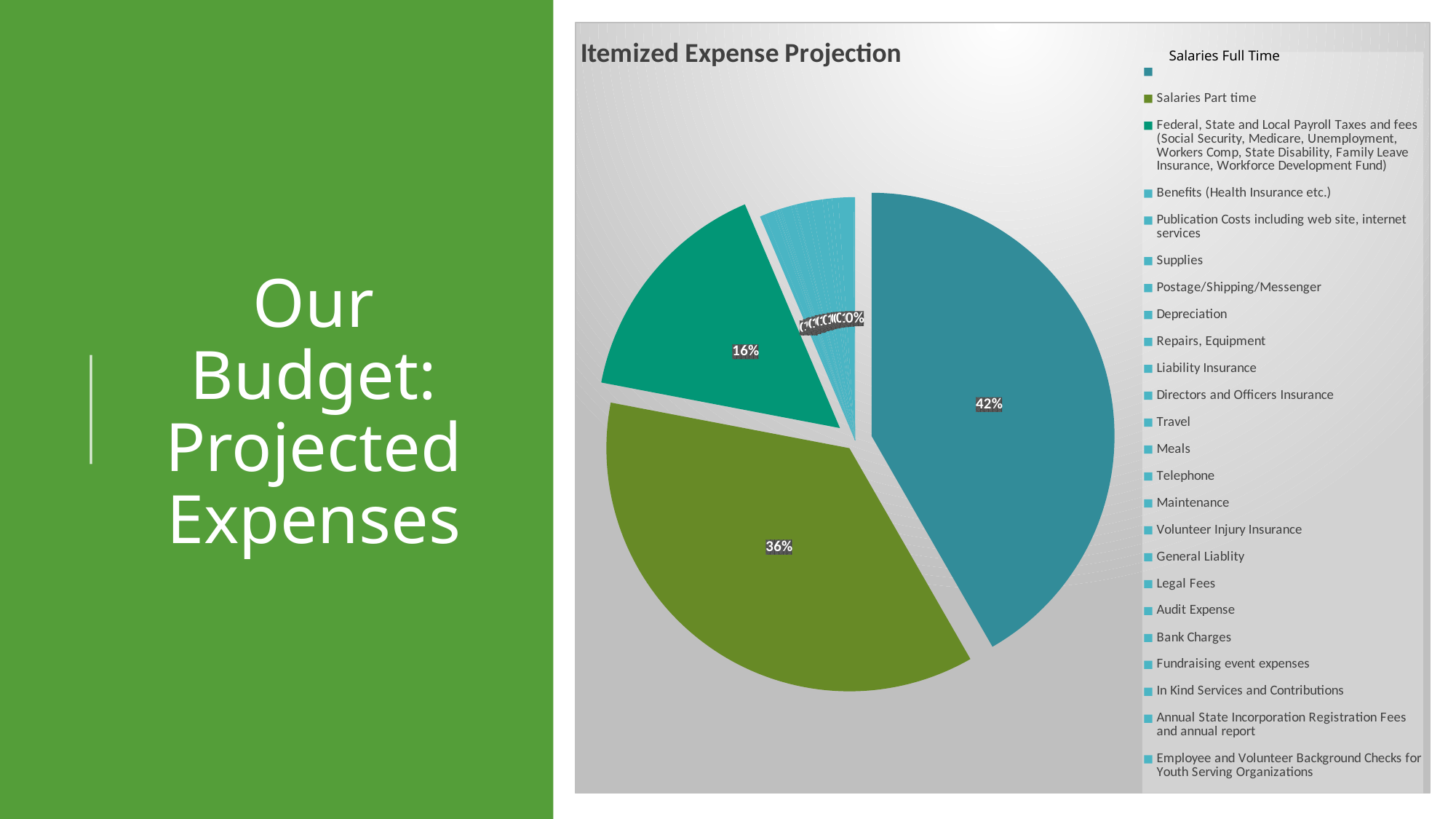
By how many percentage points does the Salaries Full Time slice exceed the Salaries Part time slice? 6 percentage points What share of the pie does Federal, State and Local Payroll Taxes and fees take? 16% Which category has the largest slice of the pie? Salaries Full Time What is the title of the chart? Itemized Expense Projection By how many percentage points does the Salaries Part time slice exceed the Federal, State and Local Payroll Taxes and fees slice? 20 percentage points What share of the pie does Salaries Full Time take? 42% What colour is the Salaries Part time slice? green Which is larger, the slice for Salaries Part time or the slice for Federal, State and Local Payroll Taxes and fees? Salaries Part time Which is larger, the slice for Salaries Full Time or the slice for Salaries Part time? Salaries Full Time What kind of chart is shown on the slide? pie chart How many categories does the legend list? 24 What share of the pie does Salaries Part time take? 36%